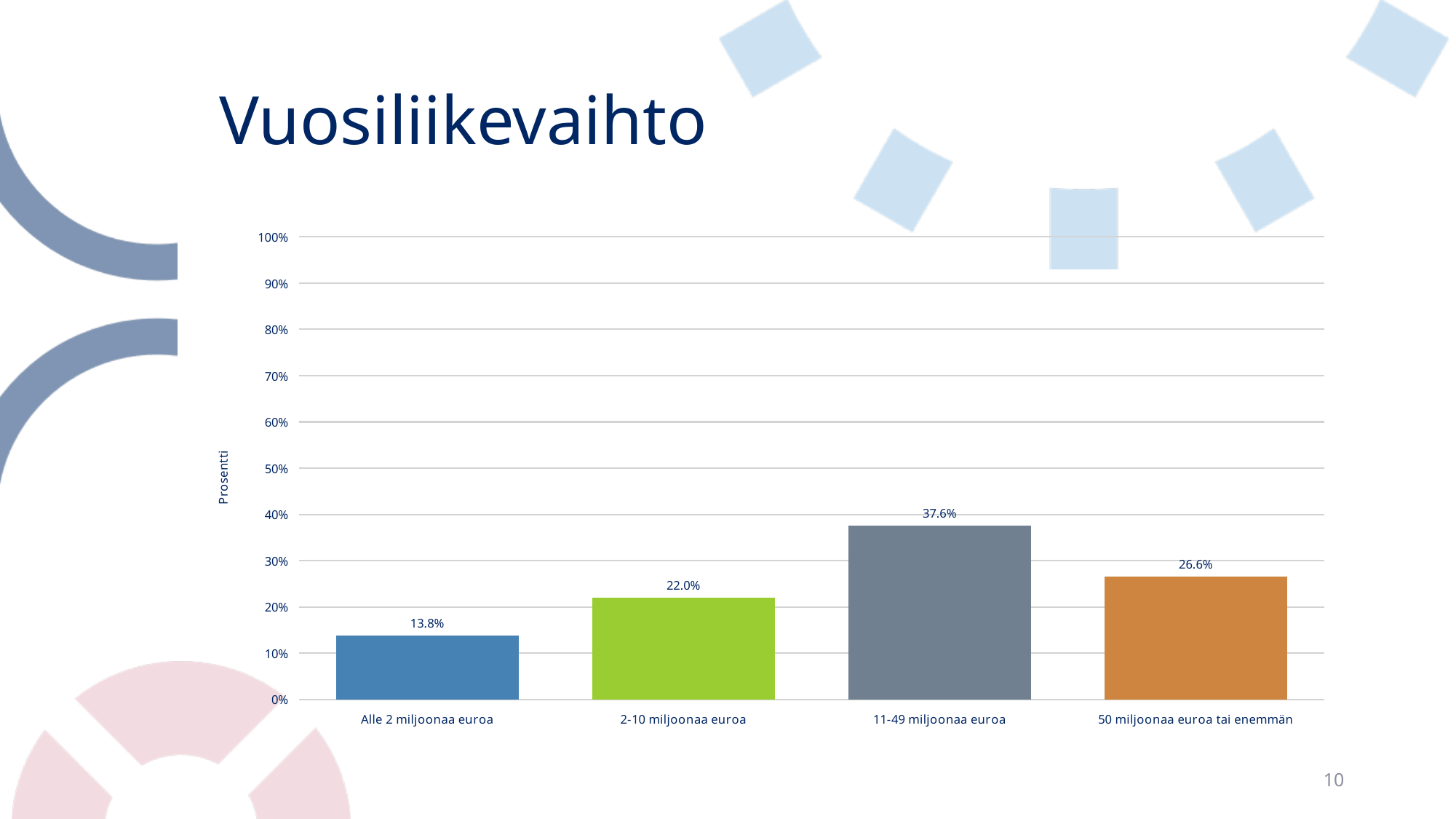
What is the label of the vertical axis? Prosentti Is the value for "11-49 miljoonaa euroa" greater or less than 30%? greater Which is larger, the value for "2-10 miljoonaa euroa" or the value for "50 miljoonaa euroa tai enemmän"? 50 miljoonaa euroa tai enemmän What is the value for "11-49 miljoonaa euroa"? 37.6% What is the difference between the values for "11-49 miljoonaa euroa" and "50 miljoonaa euroa tai enemmän"? 11.0% What is the value for "Alle 2 miljoonaa euroa"? 13.8% Which category has the highest value? 11-49 miljoonaa euroa What kind of chart is shown on the slide? bar chart What is the value for "2-10 miljoonaa euroa"? 22.0% How many categories are shown on the x axis? 4 What is the value for "50 miljoonaa euroa tai enemmän"? 26.6% Which category has the lowest value? Alle 2 miljoonaa euroa